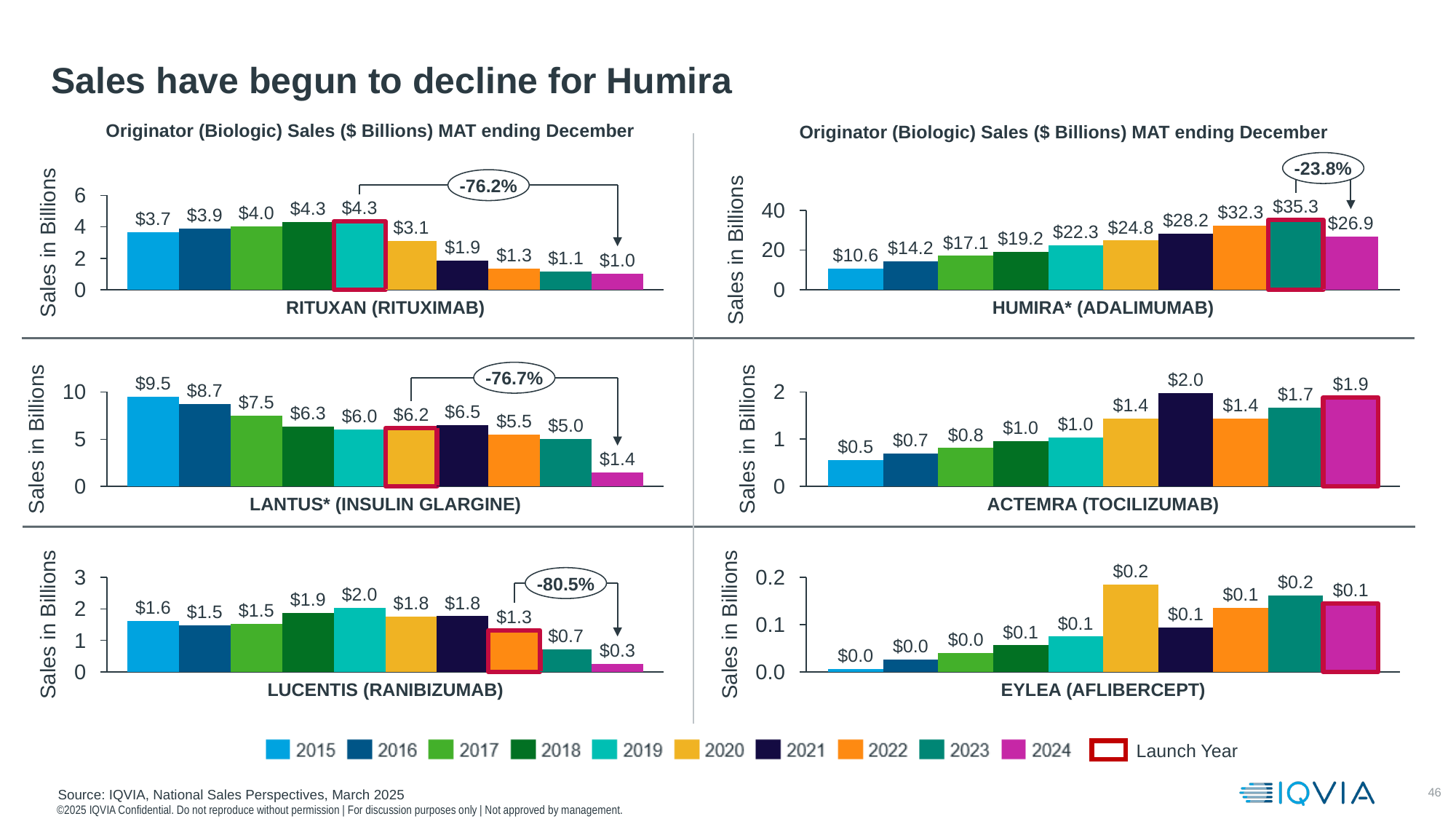
In the HUMIRA* (ADALIMUMAB) chart, what were sales in 2023? $35.3 In the LANTUS* (INSULIN GLARGINE) chart, which is larger, the 2016 value or the 2017 value? 2016 In the LUCENTIS (RANIBIZUMAB) chart, what were sales in 2019? $2.0 What percentage change is annotated above the HUMIRA* (ADALIMUMAB) chart? -23.8% In the ACTEMRA (TOCILIZUMAB) chart, which year has the highest sales? 2021 In the LANTUS* (INSULIN GLARGINE) chart, what were sales in 2015? $9.5 In the HUMIRA* (ADALIMUMAB) chart, what is the difference between the 2023 and 2024 sales values? $8.4 In the LANTUS* (INSULIN GLARGINE) chart, which year has the lowest sales? 2024 How many years does the legend at the bottom of the slide list? 10 In the HUMIRA* (ADALIMUMAB) chart, which year has the highest sales? 2023 In the RITUXAN (RITUXIMAB) chart, what were sales in 2024? $1.0 What type of chart is used for EYLEA (AFLIBERCEPT)? Bar chart